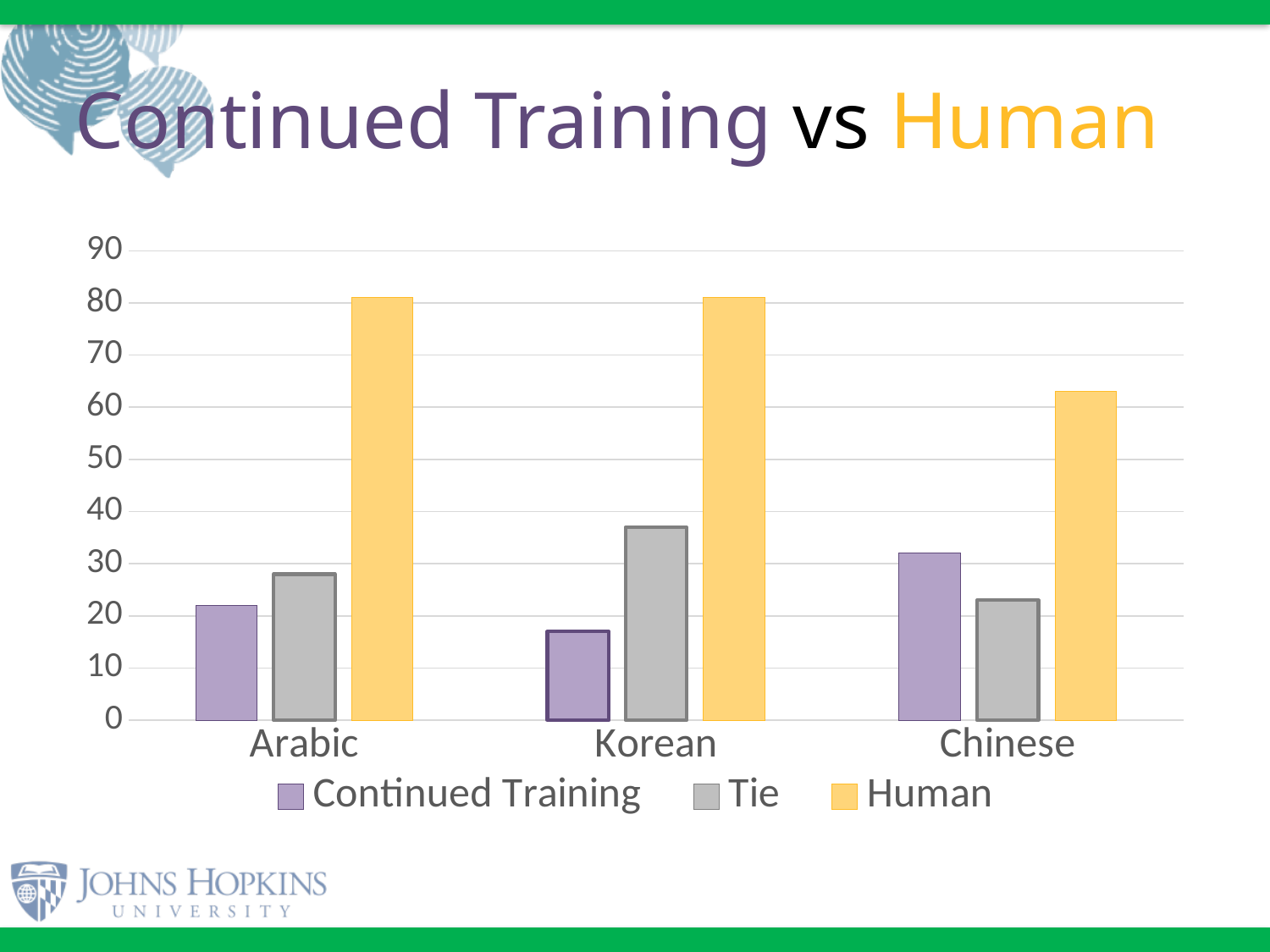
Is the Human value for Arabic greater or less than 70? greater For Chinese, which is larger: Continued Training or Tie? Continued Training What colour are the Human bars? yellow Which series has the highest value for Korean? Human Which category has the lowest Human value? Chinese Which category has the highest Tie value? Korean Which series has the lowest value for Arabic? Continued Training What kind of chart is shown on the slide? bar chart How many series does the legend list? 3 How many categories are shown on the x axis? 3 Which category has the highest Continued Training value? Chinese Is the Continued Training value for Korean greater or less than 20? less